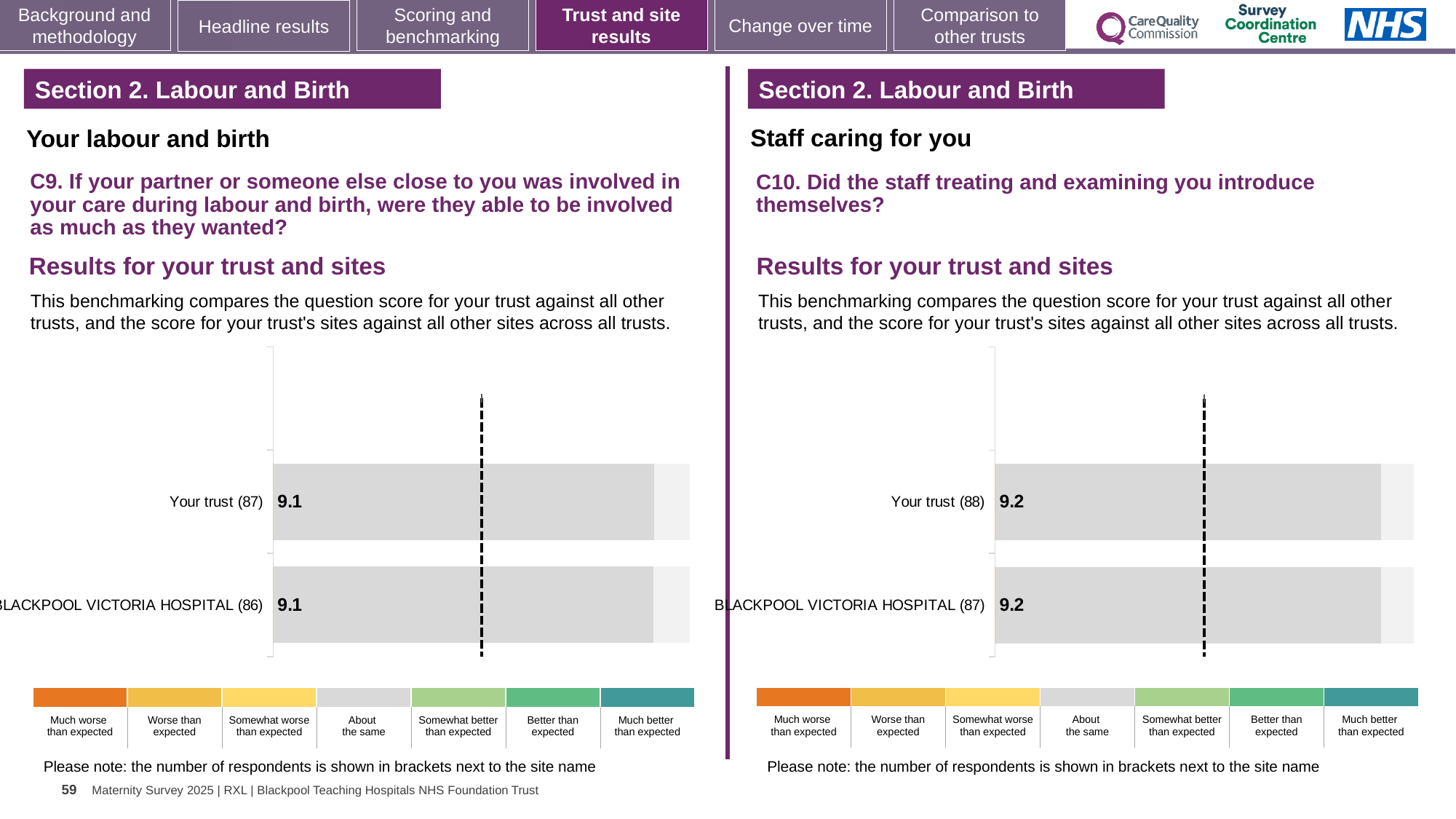
Is the score for Your trust in the right chart (C10) larger than the score for Your trust in the left chart (C9)? Yes How many bars are plotted in the left chart (C9)? 2 In the right chart (C10), what is the difference between the score for Your trust and the score for BLACKPOOL VICTORIA HOSPITAL? 0 In the left chart (C9), what is the difference between the score for Your trust and the score for BLACKPOOL VICTORIA HOSPITAL? 0 In the left chart (C9), how many respondents are shown in brackets for Your trust? 87 In the right chart (C10), what is the score for BLACKPOOL VICTORIA HOSPITAL? 9.2 In the left chart (C9), what is the score for BLACKPOOL VICTORIA HOSPITAL? 9.1 How many bars are plotted in the right chart (C10)? 2 In the left chart (C9), what is the score for Your trust? 9.1 In the right chart (C10), what is the score for Your trust? 9.2 In the right chart (C10), how many respondents are shown in brackets for BLACKPOOL VICTORIA HOSPITAL? 87 What kind of chart is used in the left chart (C9)? Bar chart